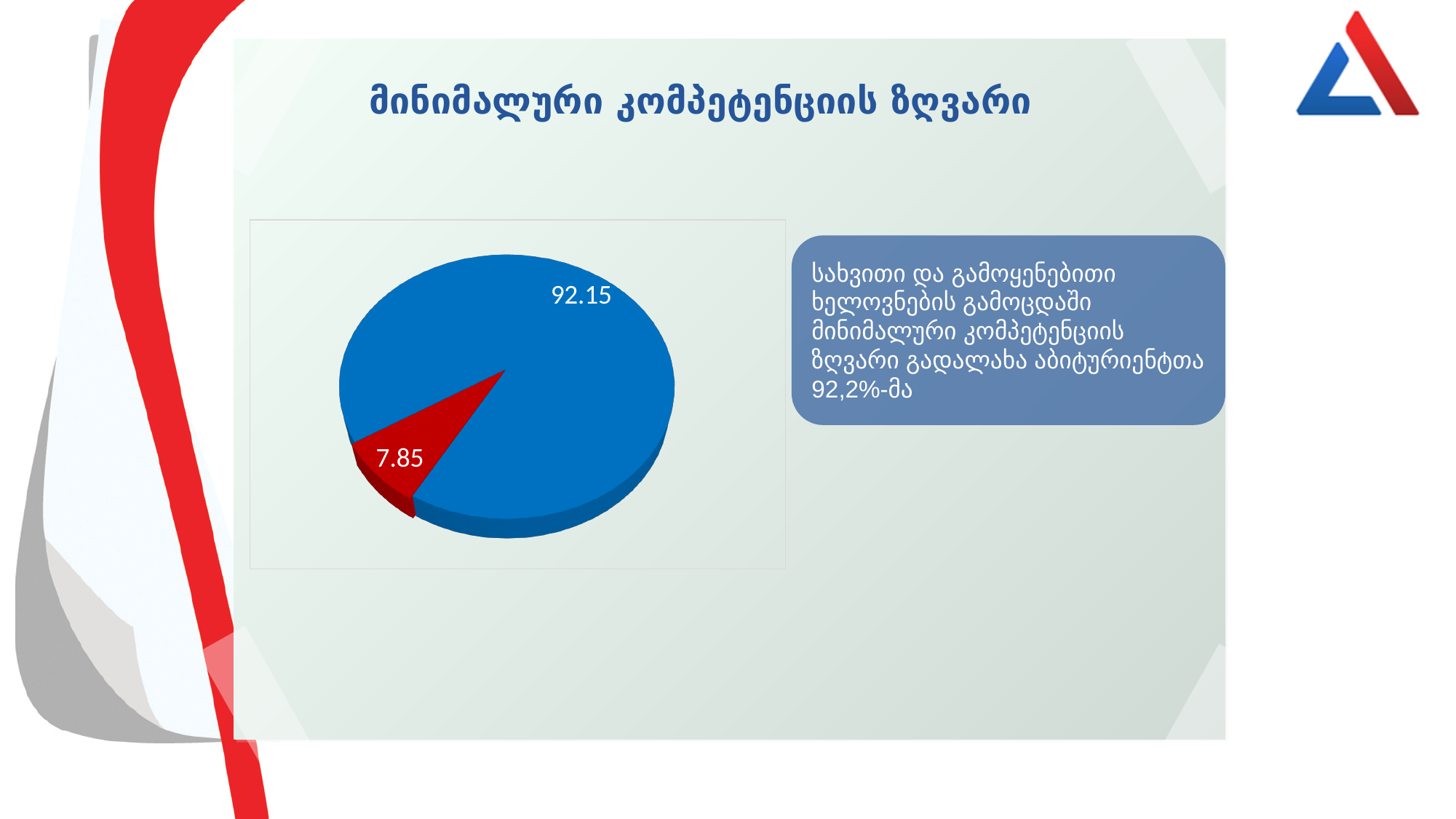
What value is labelled on the red slice of the pie chart? 7.85 What type of chart is shown on the slide? Pie chart What is the difference between the blue slice value and the red slice value in the pie chart? 84.3 What value is labelled on the blue slice of the pie chart? 92.15 Is the value of the red slice in the pie chart greater or less than 10? less What colour is the larger slice of the pie chart? Blue Which is larger in the pie chart, the blue slice or the red slice? The blue slice What is the total of the two values shown in the pie chart? 100 Which slice of the pie chart has the smallest value? The red slice (7.85) Which slice of the pie chart has the largest value? The blue slice (92.15) What is the title shown above the pie chart on the slide? მინიმალური კომპეტენციის ზღვარი How many slices does the pie chart have? 2